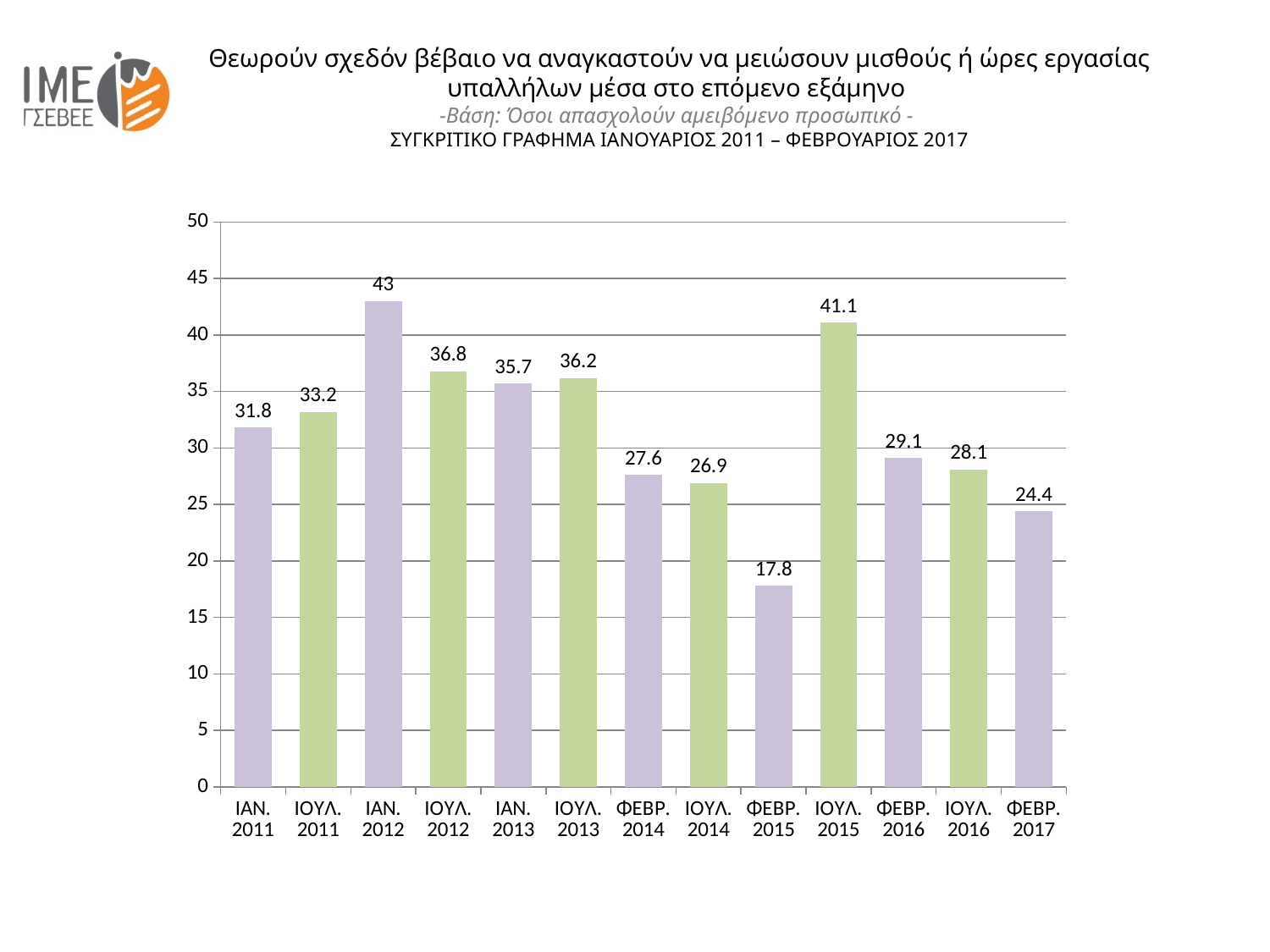
What kind of chart is shown on the slide? bar chart What is the value for ΙΟΥΛ. 2015? 41.1 Which category has the highest value? ΙΑΝ. 2012 What is the difference between the values for ΙΑΝ. 2012 and ΦΕΒΡ. 2015? 25.2 What is the value for ΙΑΝ. 2012? 43 Is the value for ΦΕΒΡ. 2014 greater or less than 30? less Do the values rise or fall from ΦΕΒΡ. 2016 to ΦΕΒΡ. 2017? fall Which is larger, the value for ΙΟΥΛ. 2012 or the value for ΙΑΝ. 2013? ΙΟΥΛ. 2012 What is the difference between the values for ΙΟΥΛ. 2015 and ΦΕΒΡ. 2016? 12 Which category has the lowest value? ΦΕΒΡ. 2015 How many categories are shown on the x axis? 13 What is the value for ΦΕΒΡ. 2017? 24.4